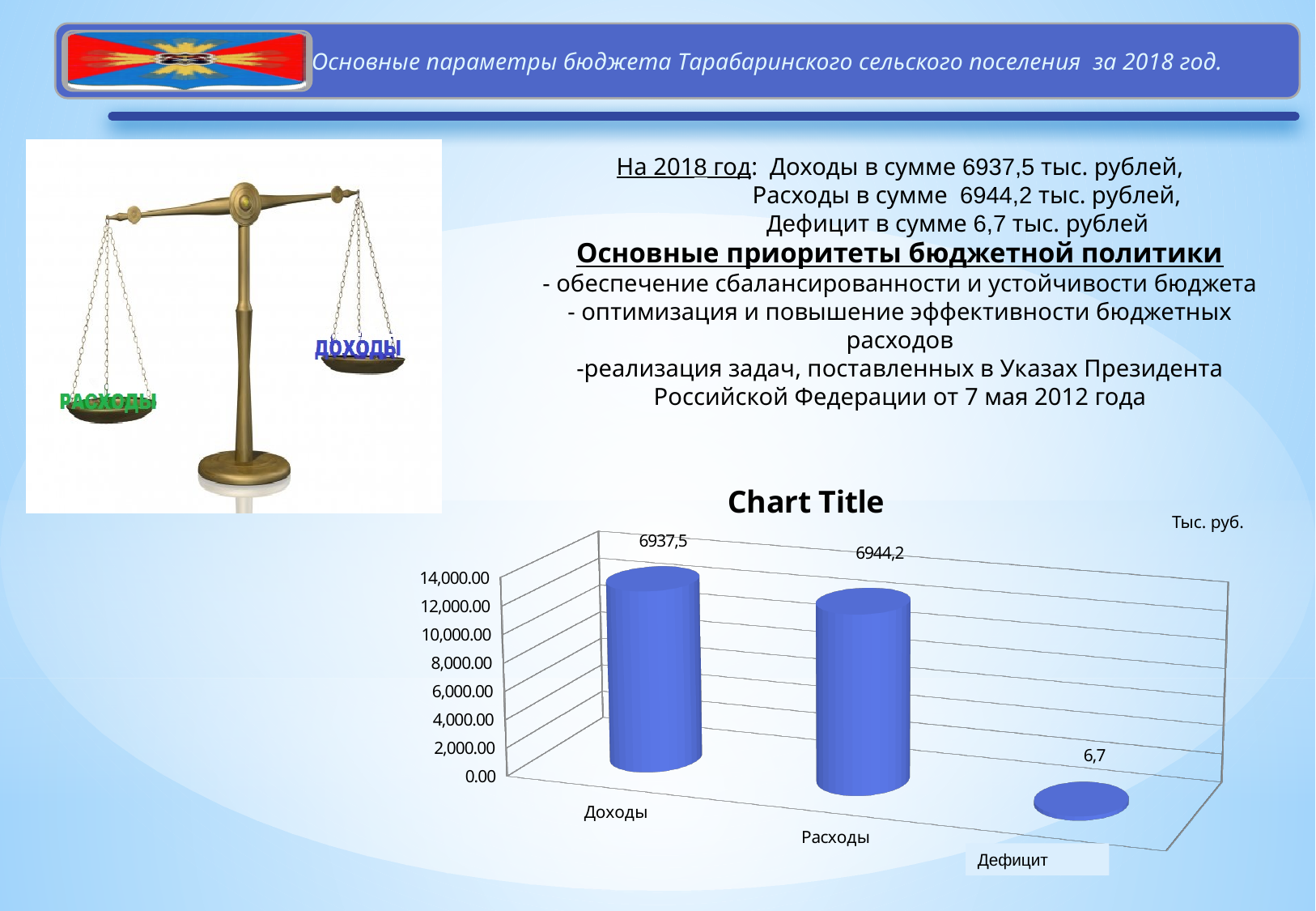
What unit is indicated next to the chart? Тыс. руб. Is the value for Дефицит greater or less than 2,000.00? less How many categories are shown in the chart? 3 What is the value for Дефицит in the chart? 6,7 Which category has the highest value in the chart? Расходы Which is larger in the chart, Доходы or Расходы? Расходы What is the difference between the values for Расходы and Доходы in the chart? 6,7 What is the title of the chart? Chart Title What kind of chart is shown on the slide? bar chart What is the value for Расходы in the chart? 6944,2 What is the value for Доходы in the chart? 6937,5 Which category has the lowest value in the chart? Дефицит